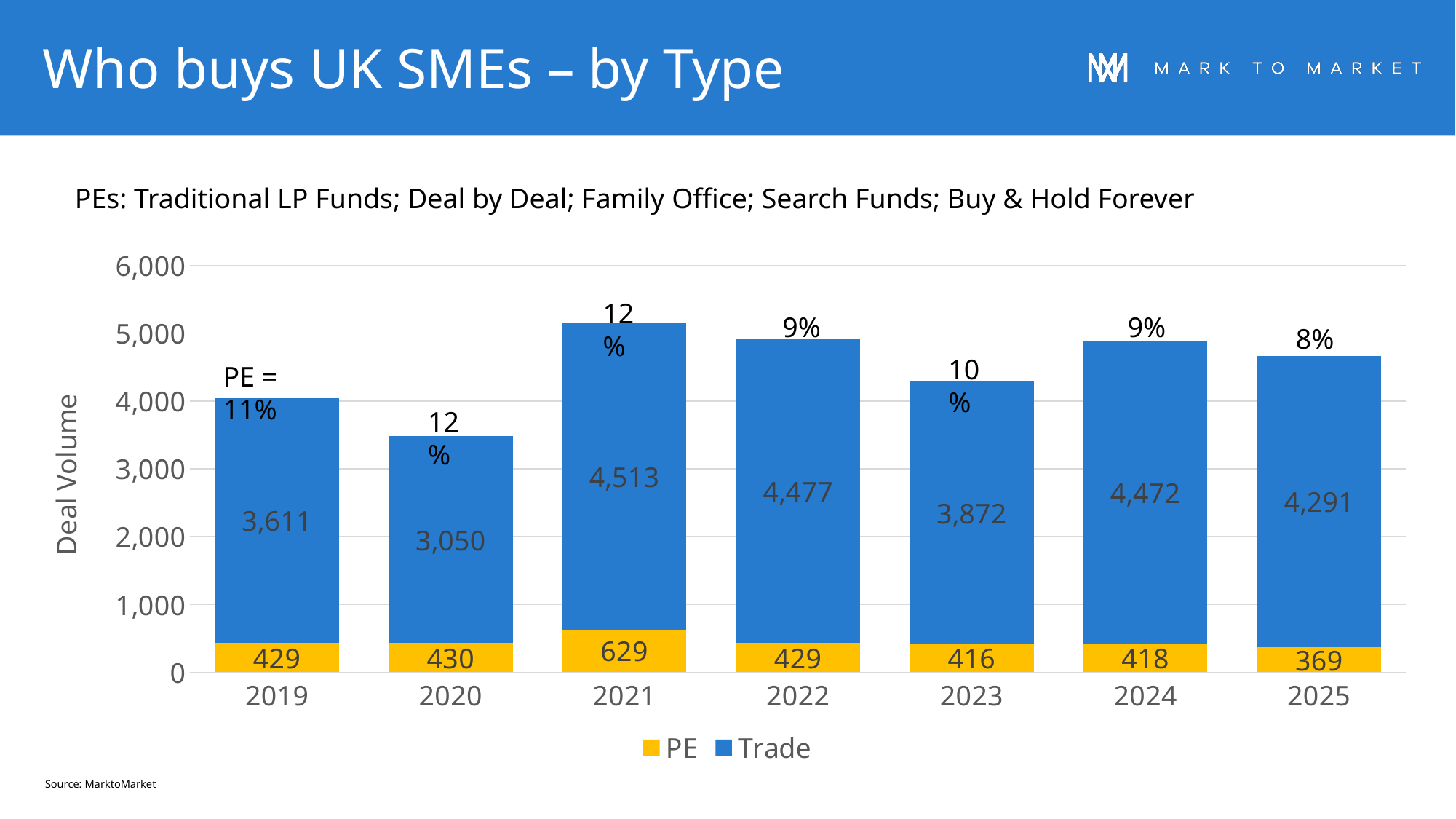
Is the total height of the 2020 stacked bar greater or less than 4,000? less Which is larger, the Trade deal volume in 2024 or in 2025? 2024 How many series does the legend list? 2 How many years are shown on the x axis? 7 What is the difference between the Trade deal volume in 2022 and in 2023? 605 What PE percentage share is labelled above the 2019 bar? 11% What is the PE deal volume for 2025? 369 What is the total deal volume (PE plus Trade) for 2021? 5,142 Which year has the highest PE deal volume? 2021 What is the Trade deal volume for 2021? 4,513 Which year has the lowest Trade deal volume? 2020 What kind of chart is shown on the slide? Stacked bar chart